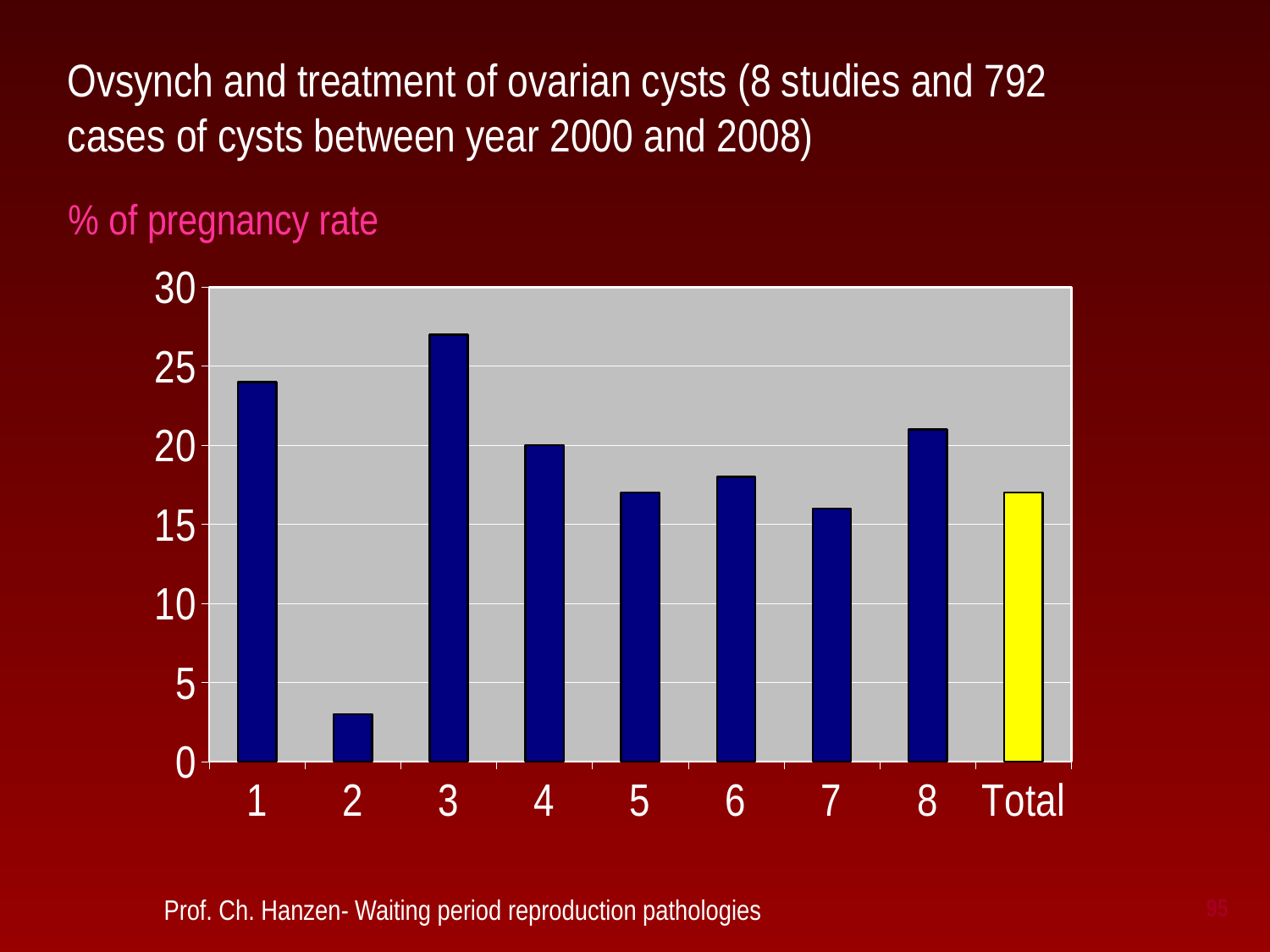
What kind of chart is shown on the slide? bar chart Which has a higher pregnancy rate, study 1 or study 8? 1 Which has a higher pregnancy rate, study 4 or study 7? 4 Which category has the lowest pregnancy rate? 2 Is the value for study 1 greater or less than 20? greater Is the value for study 7 greater or less than 20? less Is the value for Total greater or less than 15? greater Which bar is coloured yellow instead of blue? Total Which category has the highest pregnancy rate? 3 How many bars are plotted in the chart? 9